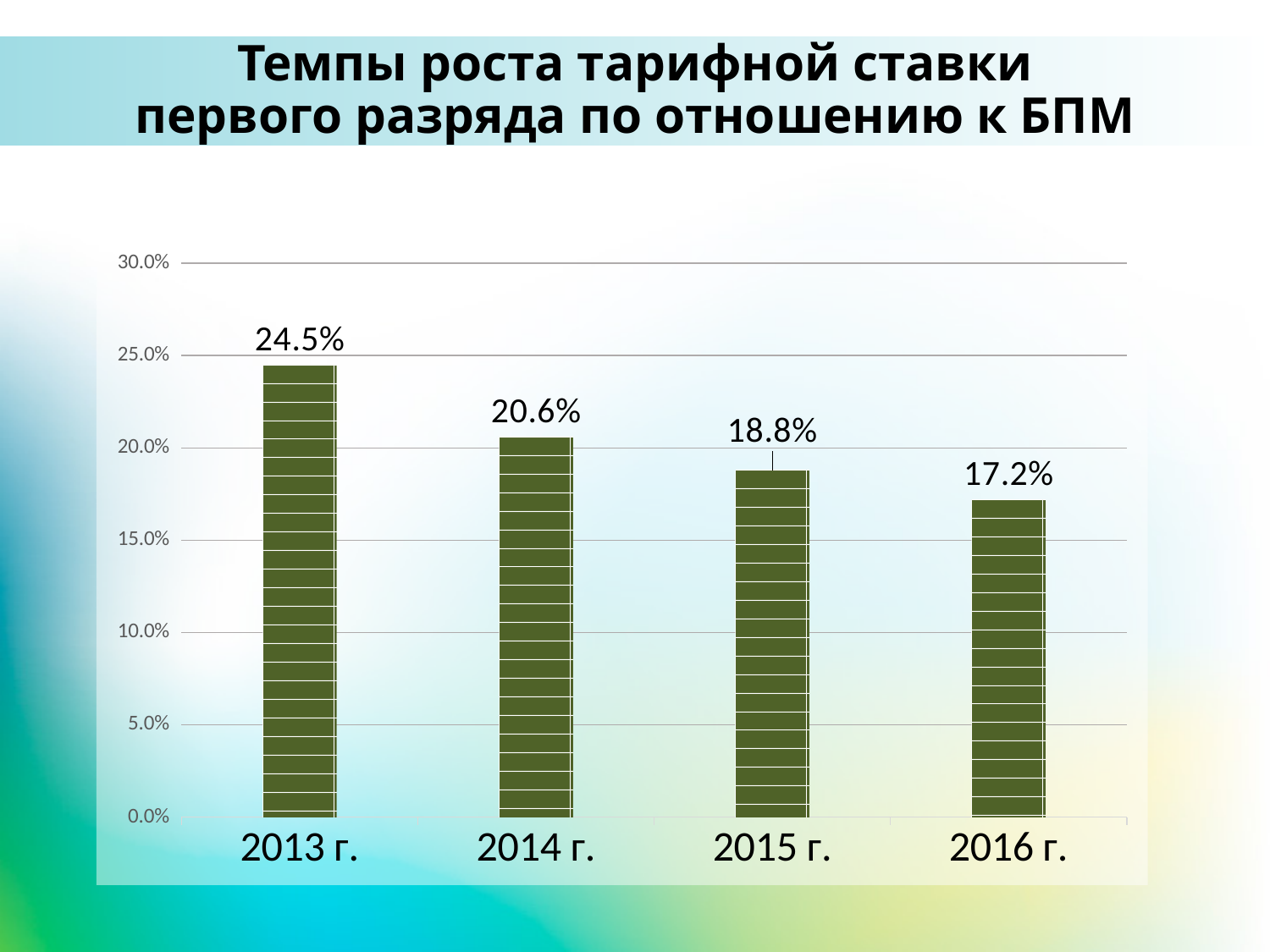
What is the value for 2016 г.? 17.2% How many years are shown on the chart? 4 What is the value for 2015 г.? 18.8% What is the value for 2014 г.? 20.6% Which is larger, the value for 2014 г. or the value for 2015 г.? 2014 г. What is the difference between the values for 2013 г. and 2016 г.? 7.3% Which year has the lowest value? 2016 г. Is the value for 2015 г. greater or less than 20.0%? less Do the values rise or fall from 2013 г. to 2016 г.? fall What is the value for 2013 г.? 24.5% Which year has the highest value? 2013 г. What kind of chart is shown on the slide? bar chart